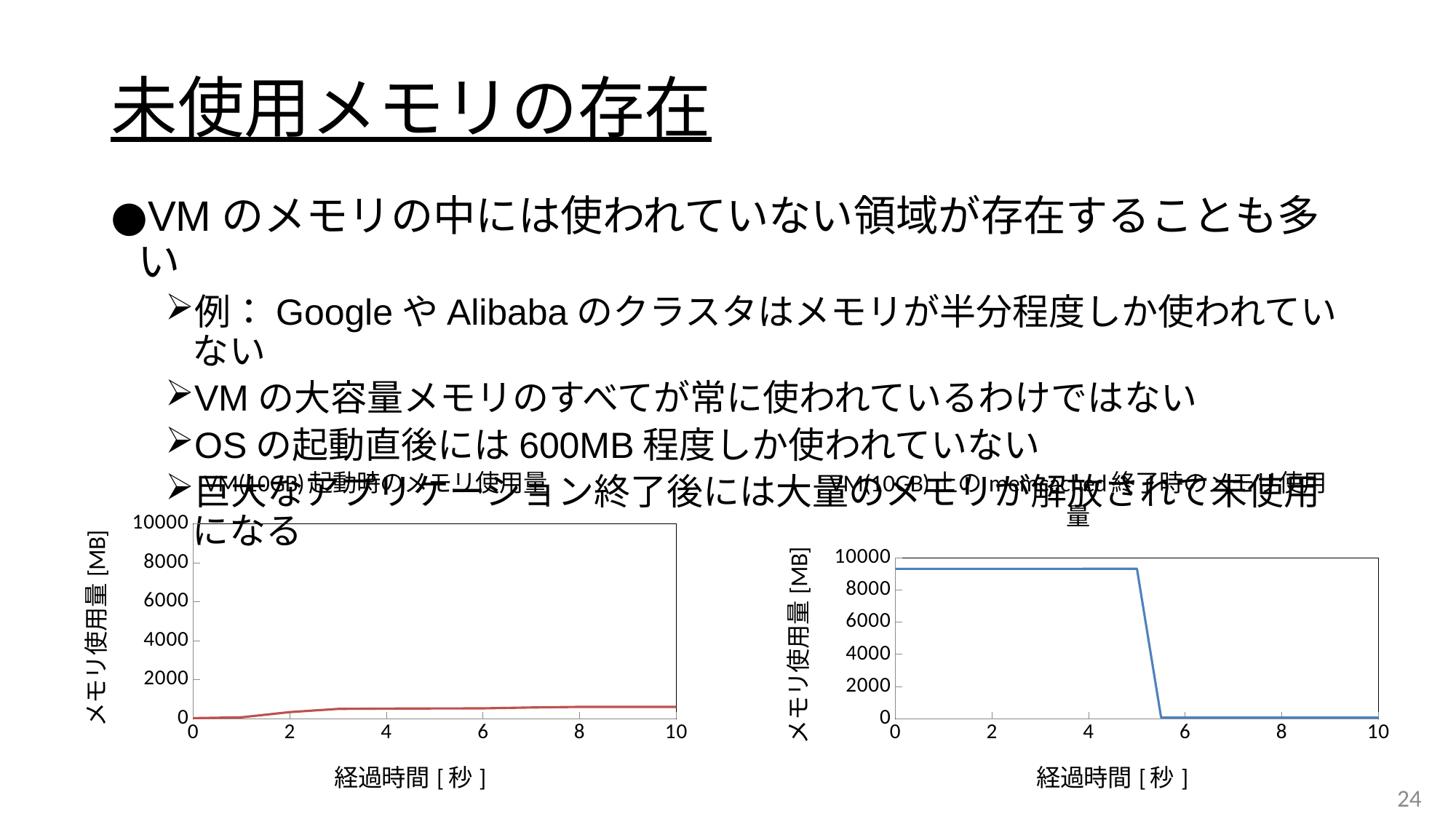
In the chart on the right, is the memory usage at 2 seconds greater or less than 8000? greater What is the label of the y axis in the chart on the left? メモリ使用量 [MB] In the chart on the left, is the memory usage at 10 seconds greater or less than 2000? less What kind of chart is the chart on the left of the slide? line chart What is the highest value shown on the y axis of the chart on the right? 10000 In the chart on the left, does memory usage rise or fall as elapsed time increases from 0 to 10 seconds? rise In the chart on the right, does memory usage rise or fall as elapsed time goes from 4 to 6 seconds? fall In the chart on the right, is the memory usage at 8 seconds greater or less than 2000? less What is the label of the x axis in the chart on the right? 経過時間 [秒] At 2 seconds of elapsed time, which chart shows the larger memory usage, the left chart or the right chart? the right chart What kind of chart is the chart on the right of the slide? line chart In the chart on the right, is the memory usage larger at 2 seconds or at 8 seconds? 2 seconds